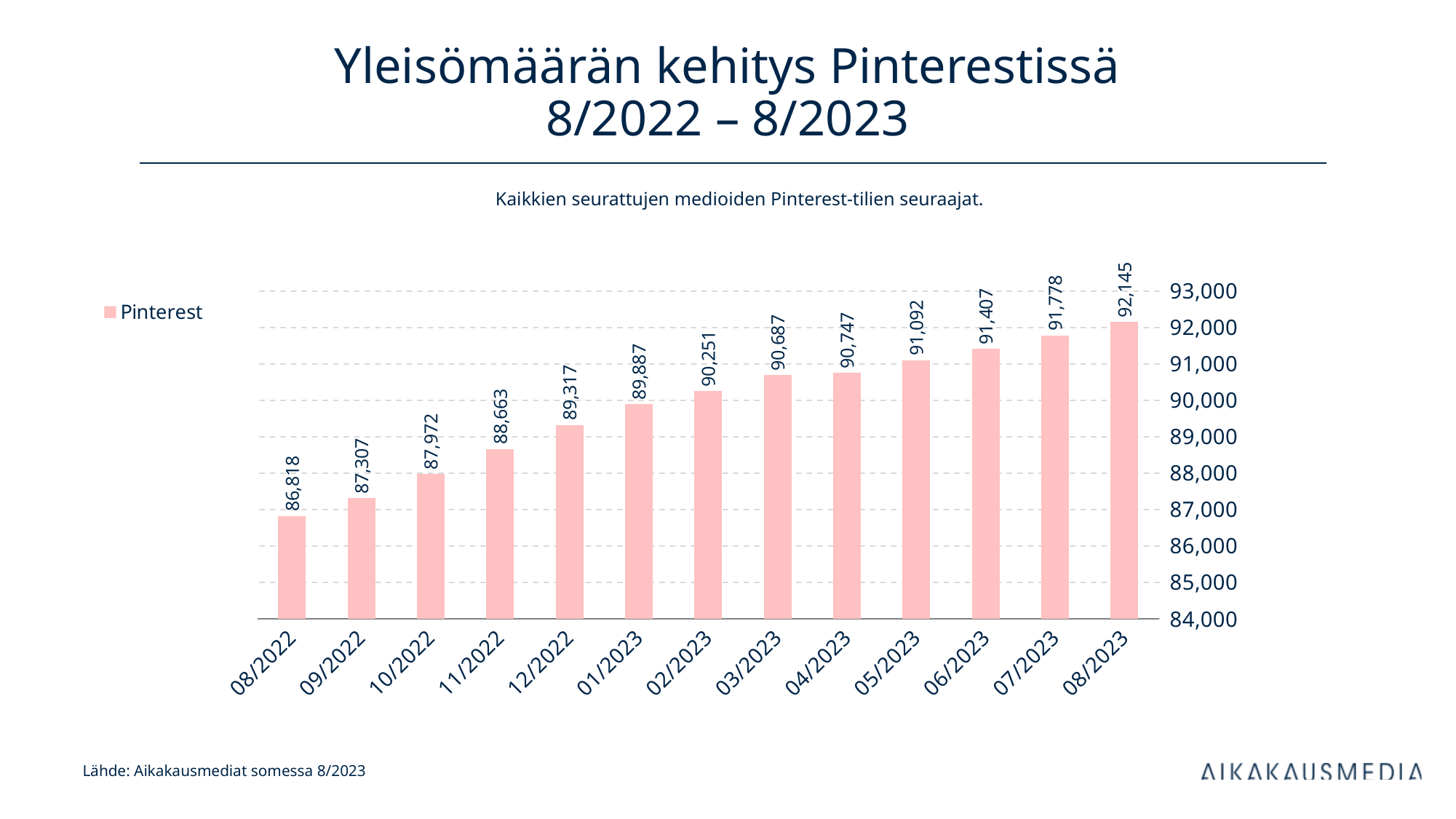
Which month has the highest value? 08/2023 Do the values rise or fall from 08/2022 to 08/2023? rise What is the value for 08/2023? 92,145 What is the value for 03/2023? 90,687 What kind of chart is this? bar chart What is the difference between the values for 08/2023 and 08/2022? 5,327 What is the value for 08/2022? 86,818 Is the value for 02/2023 greater or less than 90,000? greater How many months are shown on the x axis? 13 What is the difference between the values for 12/2022 and 11/2022? 654 Which is larger, the value for 10/2022 or the value for 01/2023? 01/2023 Which month has the lowest value? 08/2022